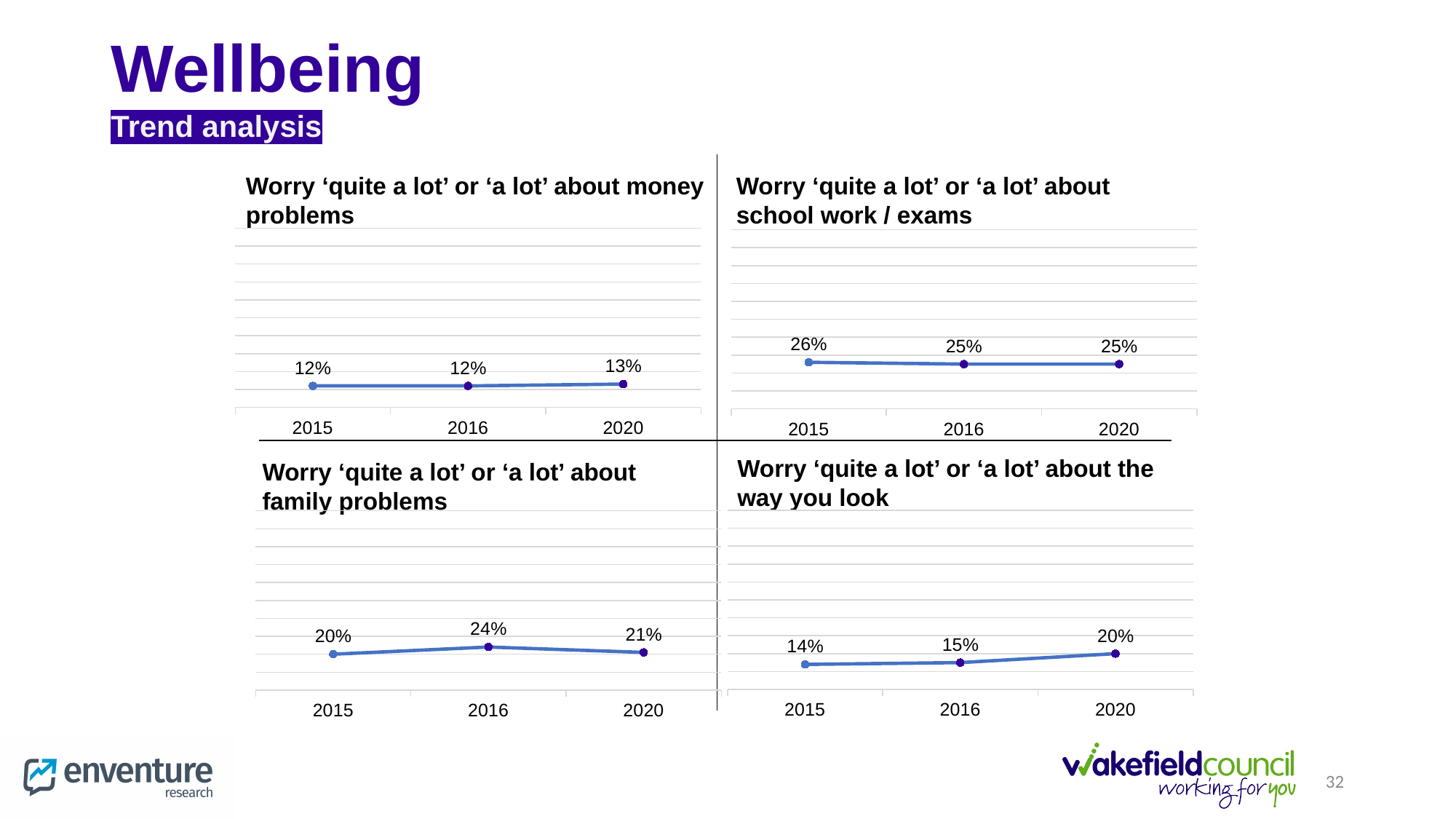
In the 'Worry about family problems' chart, what is the difference between the 2016 and 2020 values? 3% In the 'Worry about the way you look' chart, what is the difference between the 2020 and 2015 values? 6% In the 'Worry about the way you look' chart, do the values rise or fall from 2015 to 2020? rise What kind of chart is the 'Worry about the way you look' chart? line chart In the 'Worry about family problems' chart, which year has the highest value? 2016 In the 'Worry about money problems' chart, what is the value for 2020? 13% In the 'Worry about the way you look' chart, what is the value for 2020? 20% In the 'Worry about family problems' chart, what is the value for 2016? 24% In the 'Worry about the way you look' chart, which year has the lowest value? 2015 How many data points are plotted in the 'Worry about money problems' chart? 3 In the 'Worry about school work / exams' chart, what is the value for 2015? 26% In the 'Worry about school work / exams' chart, is the value for 2015 larger or smaller than the value for 2020? larger